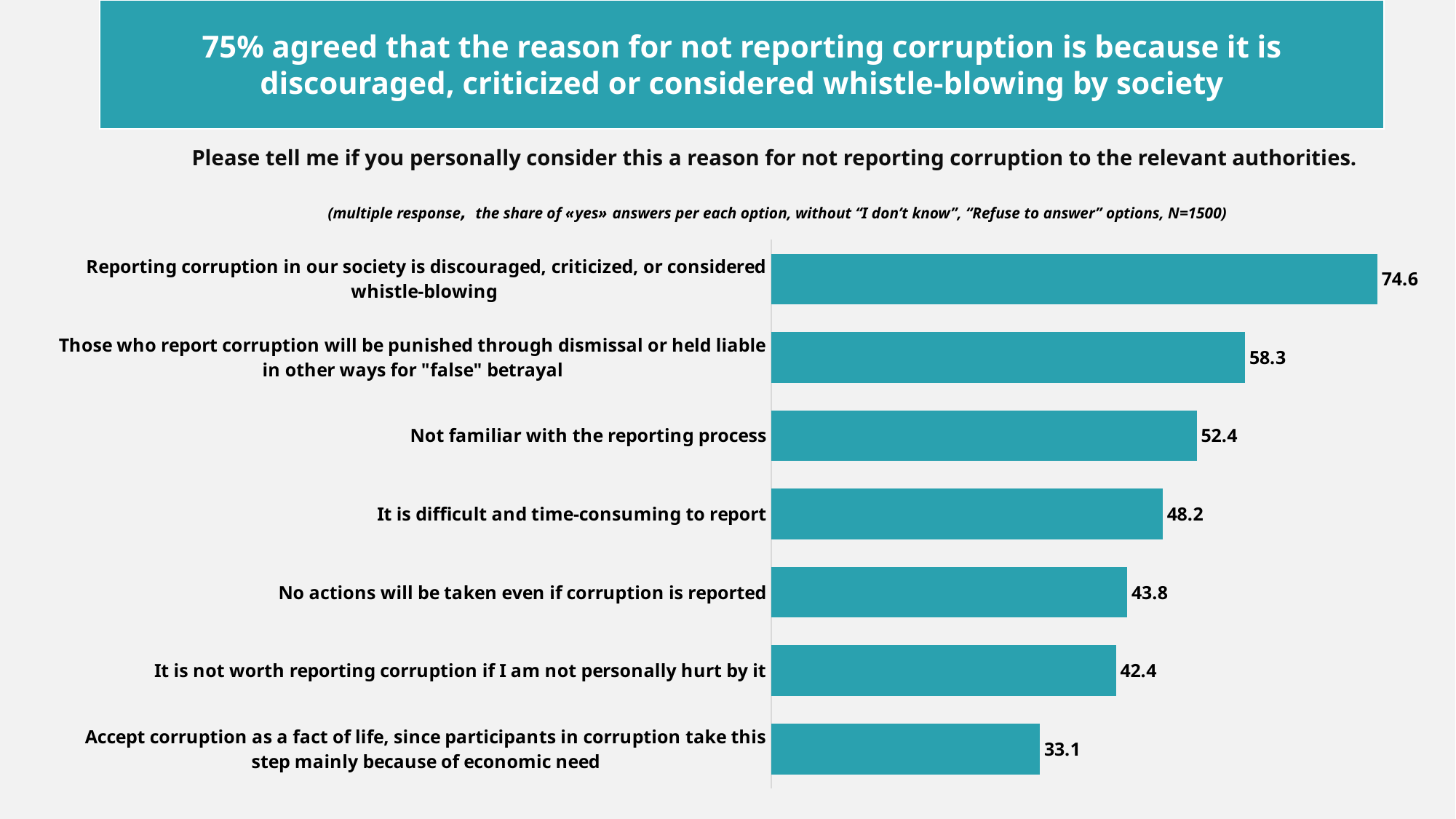
What is the value for "It is difficult and time-consuming to report"? 48.2 What kind of chart is shown on the slide? Bar chart What is the value for "No actions will be taken even if corruption is reported"? 43.8 How many categories are shown in the chart? 7 What is the value for "It is not worth reporting corruption if I am not personally hurt by it"? 42.4 What is the sample size (N) stated in the chart subtitle? N=1500 What is the value for "Not familiar with the reporting process"? 52.4 Which is larger: the value for "It is difficult and time-consuming to report" or the value for "No actions will be taken even if corruption is reported"? It is difficult and time-consuming to report What is the difference between the highest value (74.6) and the lowest value (33.1)? 41.5 Which category has the highest value? Reporting corruption in our society is discouraged, criticized, or considered whistle-blowing Which category has the lowest value? Accept corruption as a fact of life, since participants in corruption take this step mainly because of economic need What is the difference between "Those who report corruption will be punished through dismissal or held liable in other ways for 'false' betrayal" and "Not familiar with the reporting process"? 5.9